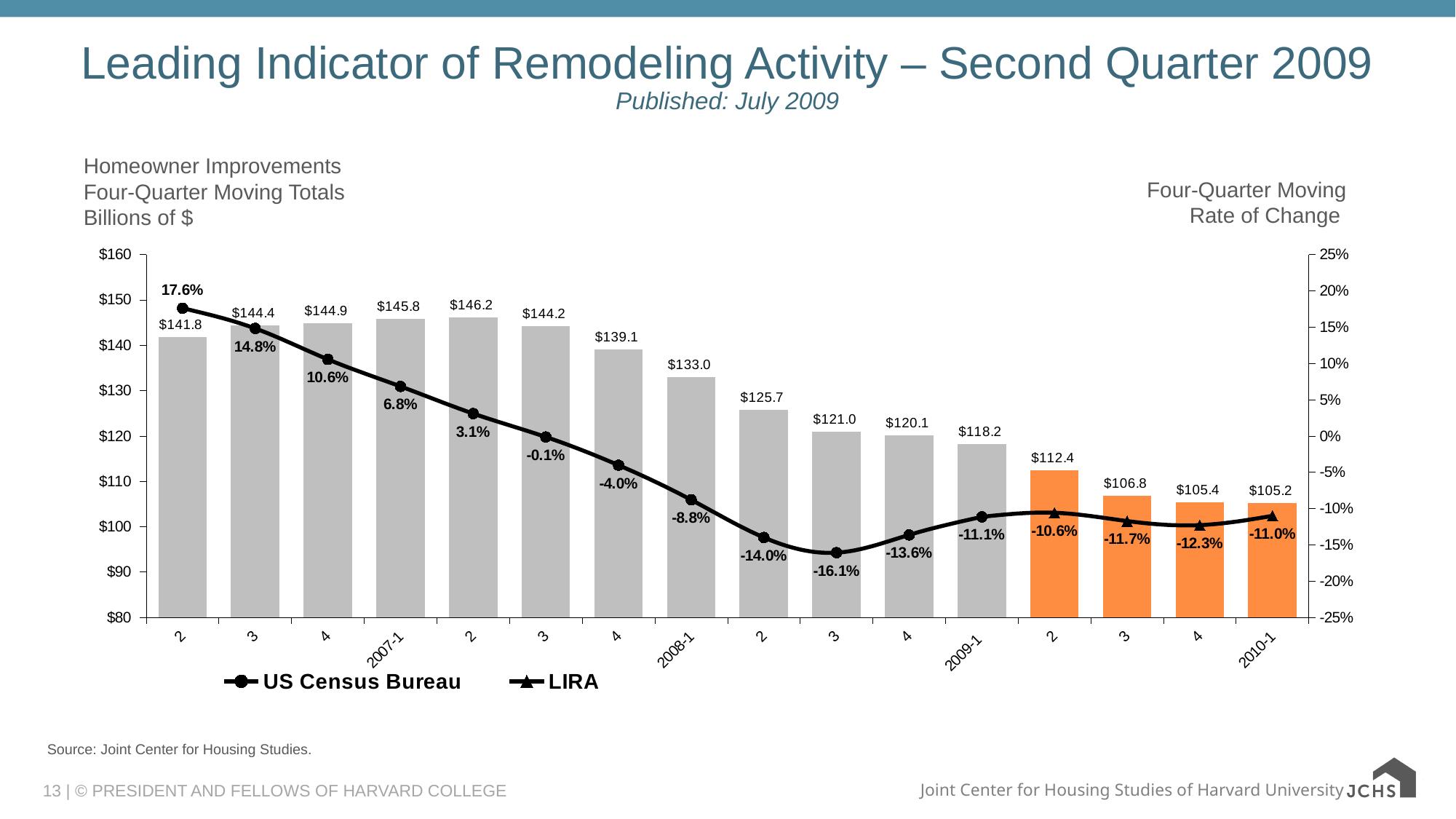
How many bars (quarters) are plotted in the chart? 16 What is the difference between the four-quarter moving totals for 2007-1 and 2008-1? $12.8 What is the four-quarter moving total for 2010-1? $105.2 What is the four-quarter moving rate of change for 2009-1? -11.1% What are the two series named in the legend? US Census Bureau and LIRA What kind of chart is shown on the slide? Combined bar and line chart Which is larger, the four-quarter moving total for 2009-1 or for 2010-1? 2009-1 Which quarter has the highest four-quarter moving total bar? 2007 quarter 2 ($146.2) What is the four-quarter moving total (in billions of $) for 2008-1? $133.0 Which quarter has the lowest four-quarter moving rate of change on the line? 2008 quarter 3 (-16.1%) Do the four-quarter moving totals generally rise or fall from 2007-1 to 2010-1? Fall How many series does the legend list? 2